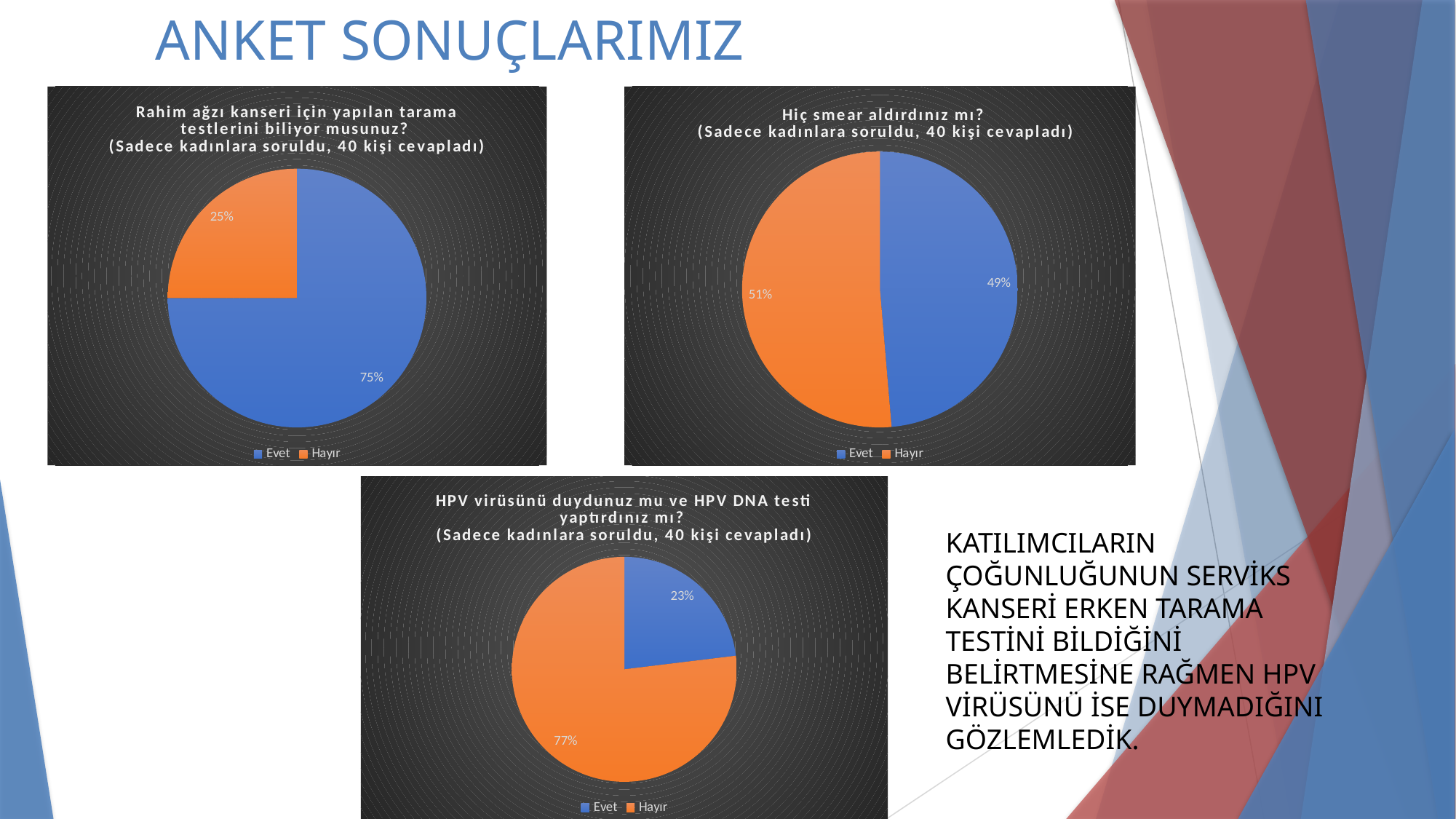
In the bottom chart (HPV virüsünü duydunuz mu ve HPV DNA testi yaptırdınız mı?), what share of respondents answered Hayır? 77% In the top-left chart (Rahim ağzı kanseri için yapılan tarama testlerini biliyor musunuz?), what share of respondents answered Hayır? 25% What type of chart is used for the top-right chart (Hiç smear aldırdınız mı?)? Pie chart How many entries does the legend of the bottom chart (HPV virüsünü duydunuz mu ve HPV DNA testi yaptırdınız mı?) list? 2 In the top-left chart (Rahim ağzı kanseri için yapılan tarama testlerini biliyor musunuz?), what is the difference in percentage points between Evet and Hayır? 50 In the bottom chart (HPV virüsünü duydunuz mu ve HPV DNA testi yaptırdınız mı?), which answer has the smaller slice? Evet In the bottom chart (HPV virüsünü duydunuz mu ve HPV DNA testi yaptırdınız mı?), what share of respondents answered Evet? 23% In the top-right chart (Hiç smear aldırdınız mı?), what share of respondents answered Hayır? 51% In the top-right chart (Hiç smear aldırdınız mı?), what share of respondents answered Evet? 49% In the top-left chart (Rahim ağzı kanseri için yapılan tarama testlerini biliyor musunuz?), which answer has the larger slice? Evet In the top-left chart (Rahim ağzı kanseri için yapılan tarama testlerini biliyor musunuz?), what colour represents Hayır? Orange In the top-left chart (Rahim ağzı kanseri için yapılan tarama testlerini biliyor musunuz?), what share of respondents answered Evet? 75%